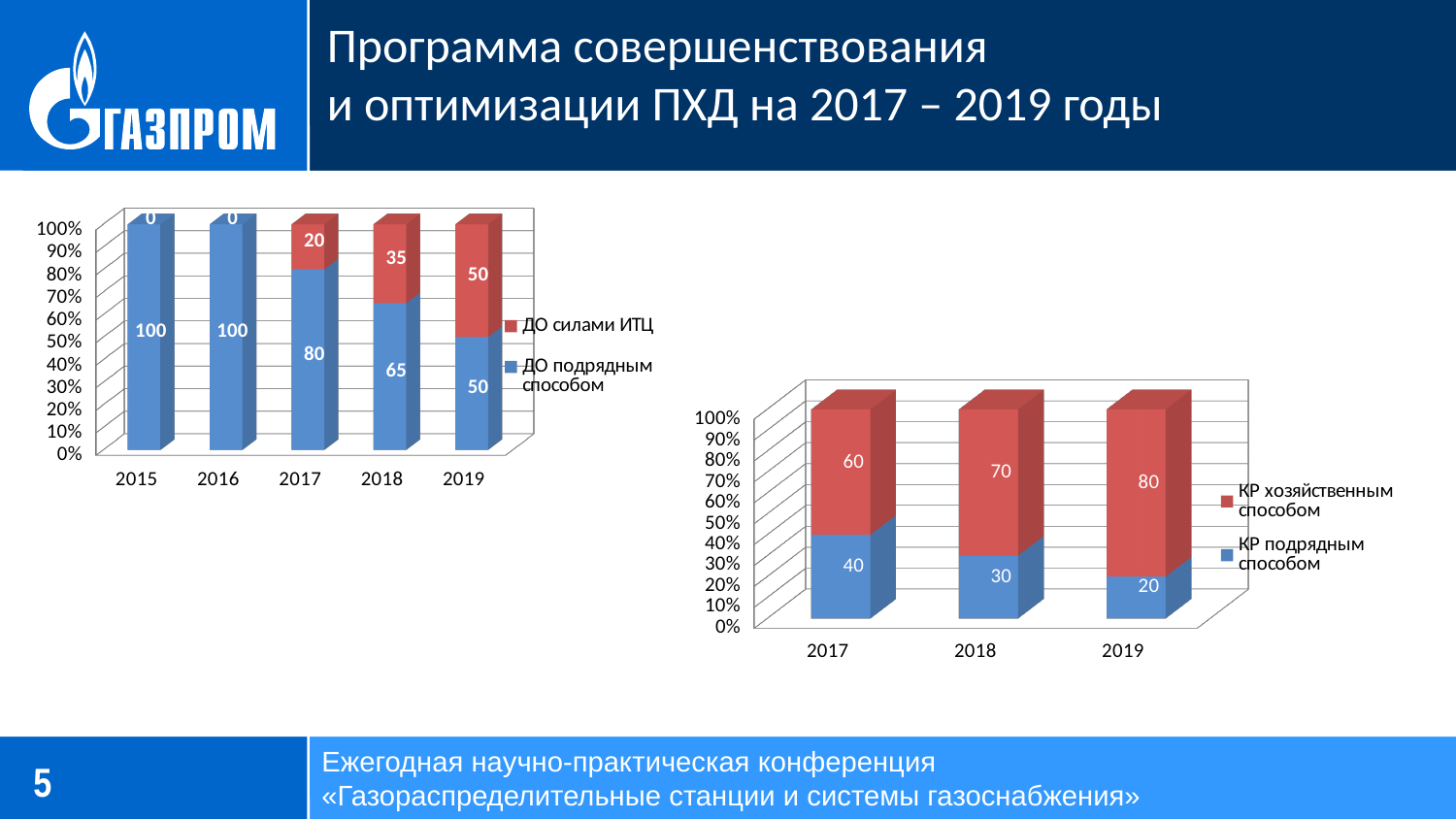
How many series does the legend of the right chart list? 2 In the left chart, which year has the highest value for "ДО силами ИТЦ"? 2019 In the left chart, what is the value for "ДО подрядным способом" in 2017? 80 In the right chart, what is the value for "КР подрядным способом" in 2019? 20 In the left chart, what is the value for "ДО силами ИТЦ" in 2018? 35 In the right chart, which year has the lowest value for "КР подрядным способом"? 2019 In the right chart, which is larger in 2017: "КР хозяйственным способом" or "КР подрядным способом"? КР хозяйственным способом In the right chart, does the value for "КР хозяйственным способом" rise or fall from 2017 to 2019? Rise How many years are shown on the x axis of the left chart? 5 What kind of chart is the right chart? Stacked bar chart In the right chart, what is the value for "КР хозяйственным способом" in 2018? 70 In the left chart, what is the difference between the "ДО подрядным способом" values for 2016 and 2018? 35